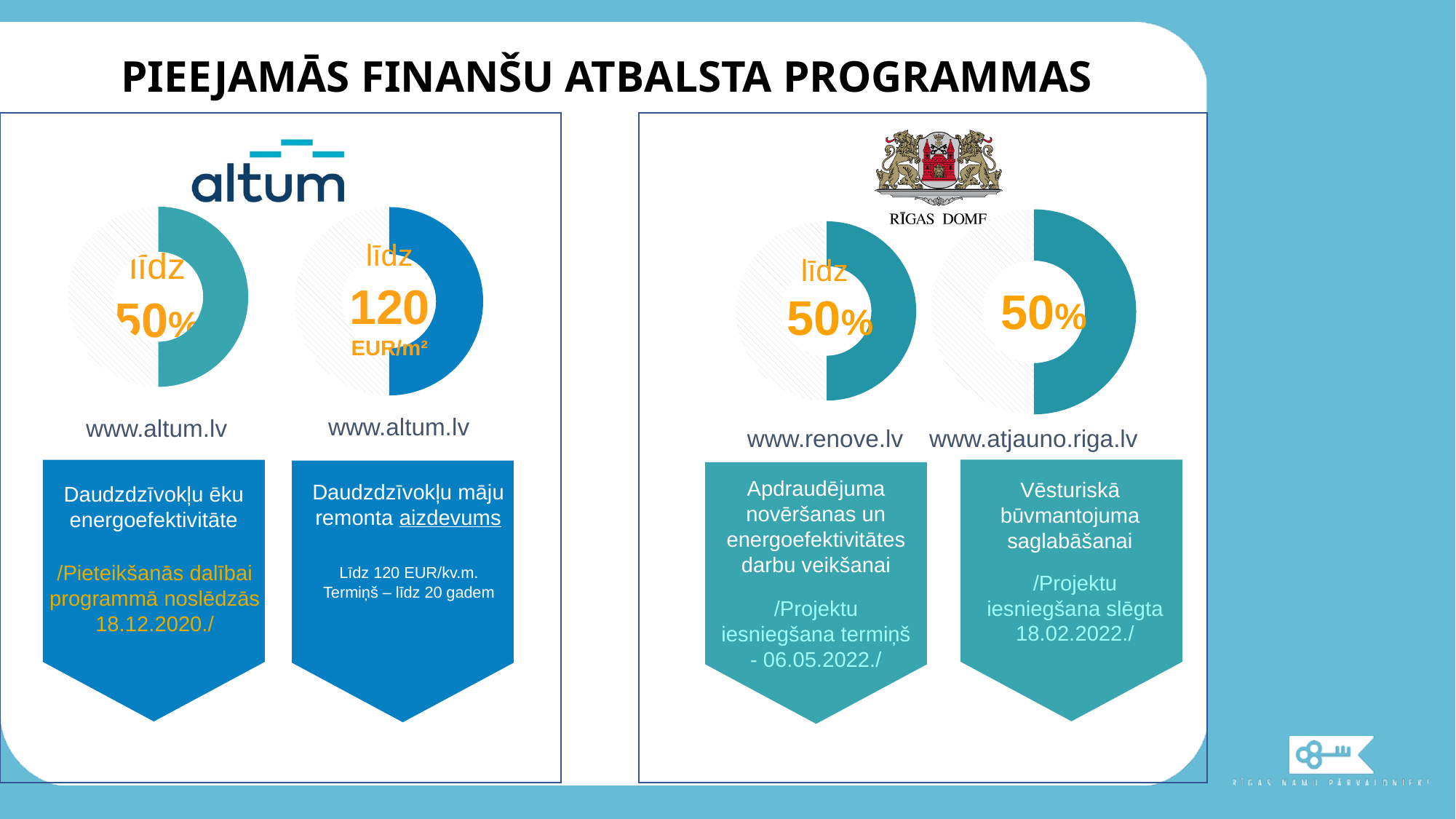
What kind of chart is used for the four graphics with values inside them? donut chart In the left (altum) panel, what value is printed inside the first donut chart? 50% What website is printed under the donut chart showing 120 EUR/m²? www.altum.lv In the right (Rīgas dome) panel, what value is printed inside the donut chart above www.atjauno.riga.lv? 50% What website is printed under the first donut chart in the left (altum) panel? www.altum.lv In the left (altum) panel, what value is printed inside the second donut chart? 120 EUR/m² How many donut charts are in the right (Rīgas dome) panel? 2 In the right (Rīgas dome) panel, what value is printed inside the donut chart above www.renove.lv? 50% How many donut charts are shown on the slide in total? 4 What unit is printed below the number 120 in the second altum donut chart? EUR/m² According to its label, what share does the first altum donut chart represent? 50% How many donut charts are in the left (altum) panel? 2